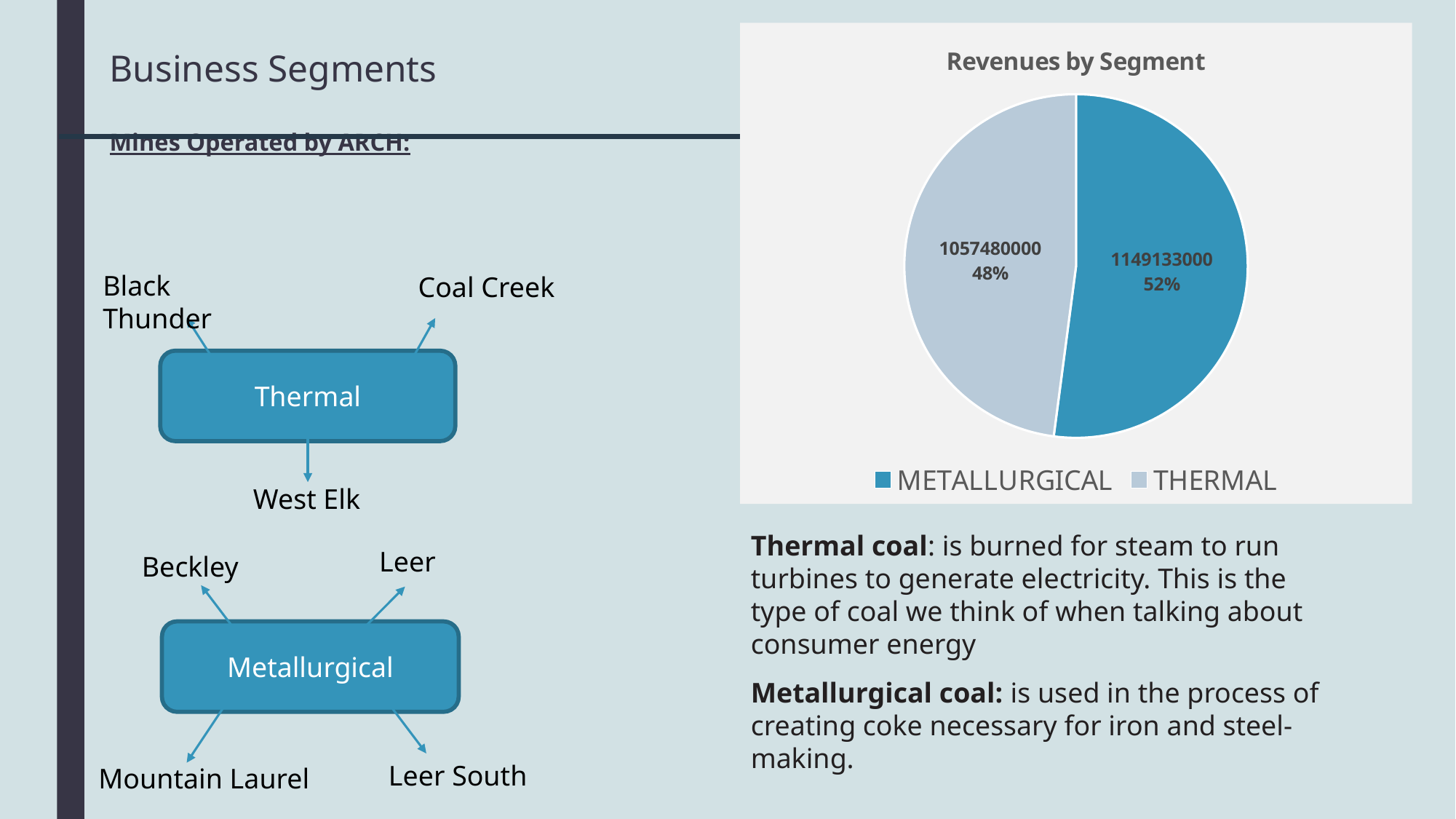
What share of the pie does the THERMAL segment represent? 48% What share of the pie does the METALLURGICAL segment represent? 52% Which segment is shown in the lighter grey-blue colour in the pie chart? THERMAL How many segments are shown in the pie chart? 2 What is the revenue value for the THERMAL segment in the pie chart? 1057480000 Is the revenue for METALLURGICAL larger or smaller than the revenue for THERMAL? larger What is the title of the pie chart? Revenues by Segment Which segment has the smaller revenue in the pie chart? THERMAL Which segment has the larger revenue in the pie chart? METALLURGICAL What kind of chart is shown on the slide? pie chart What is the difference between the METALLURGICAL and THERMAL revenue values? 91653000 What is the revenue value for the METALLURGICAL segment in the pie chart? 1149133000